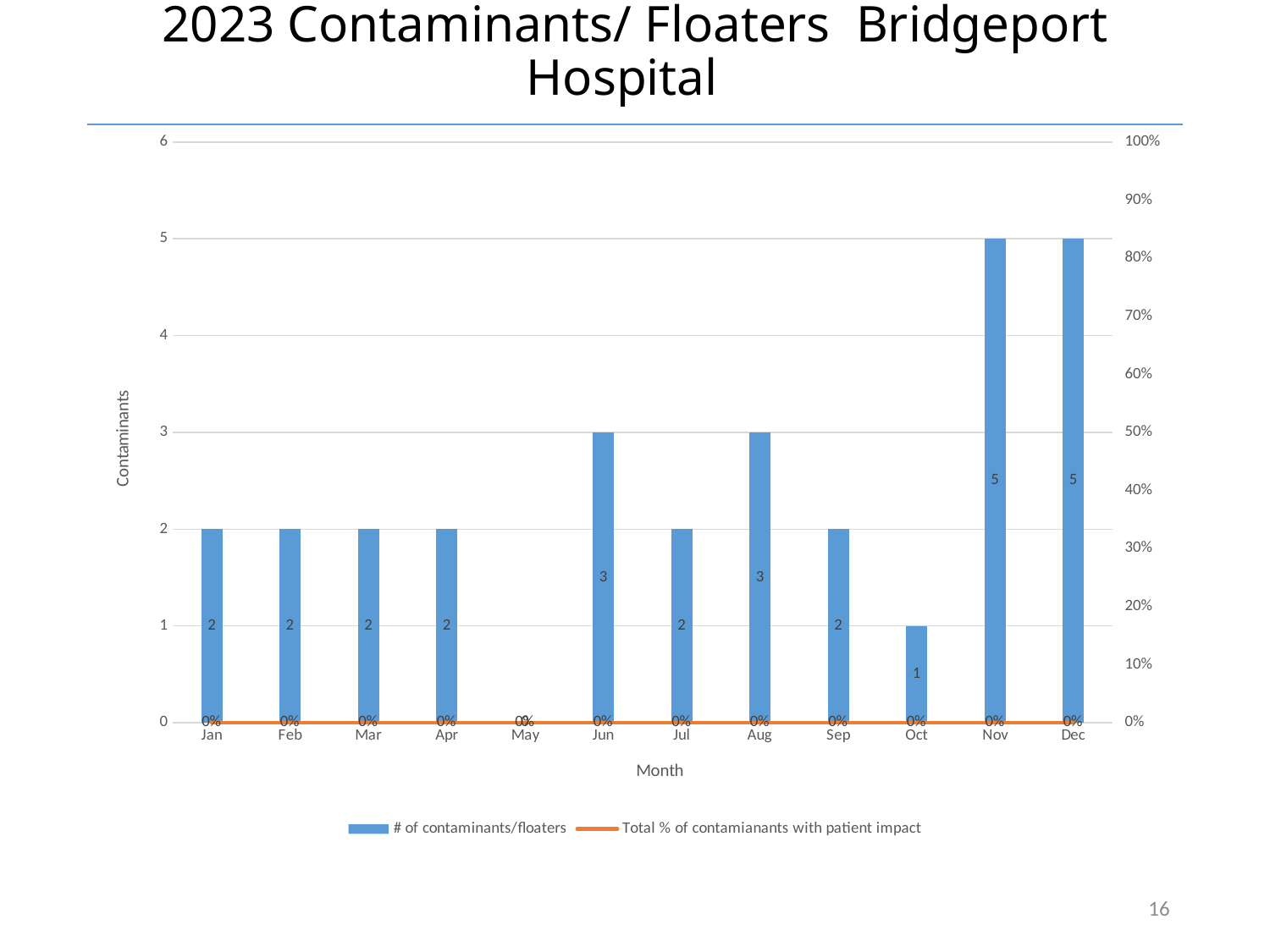
What is the label of the y axis on the left? Contaminants What is the difference between the number of contaminants/floaters in December and in October? 4 Which month has more contaminants/floaters, August or September? Aug What is the Total % of contaminants with patient impact in August? 0% What kind of chart is used for the # of contaminants/floaters series? Bar chart Which months have the highest number of contaminants/floaters? Nov and Dec What is the number of contaminants/floaters in June? 3 How many months are shown on the x axis? 12 What is the number of contaminants/floaters in November? 5 How many series does the legend list? 2 What is the number of contaminants/floaters in October? 1 Which month has the lowest number of contaminants/floaters? May